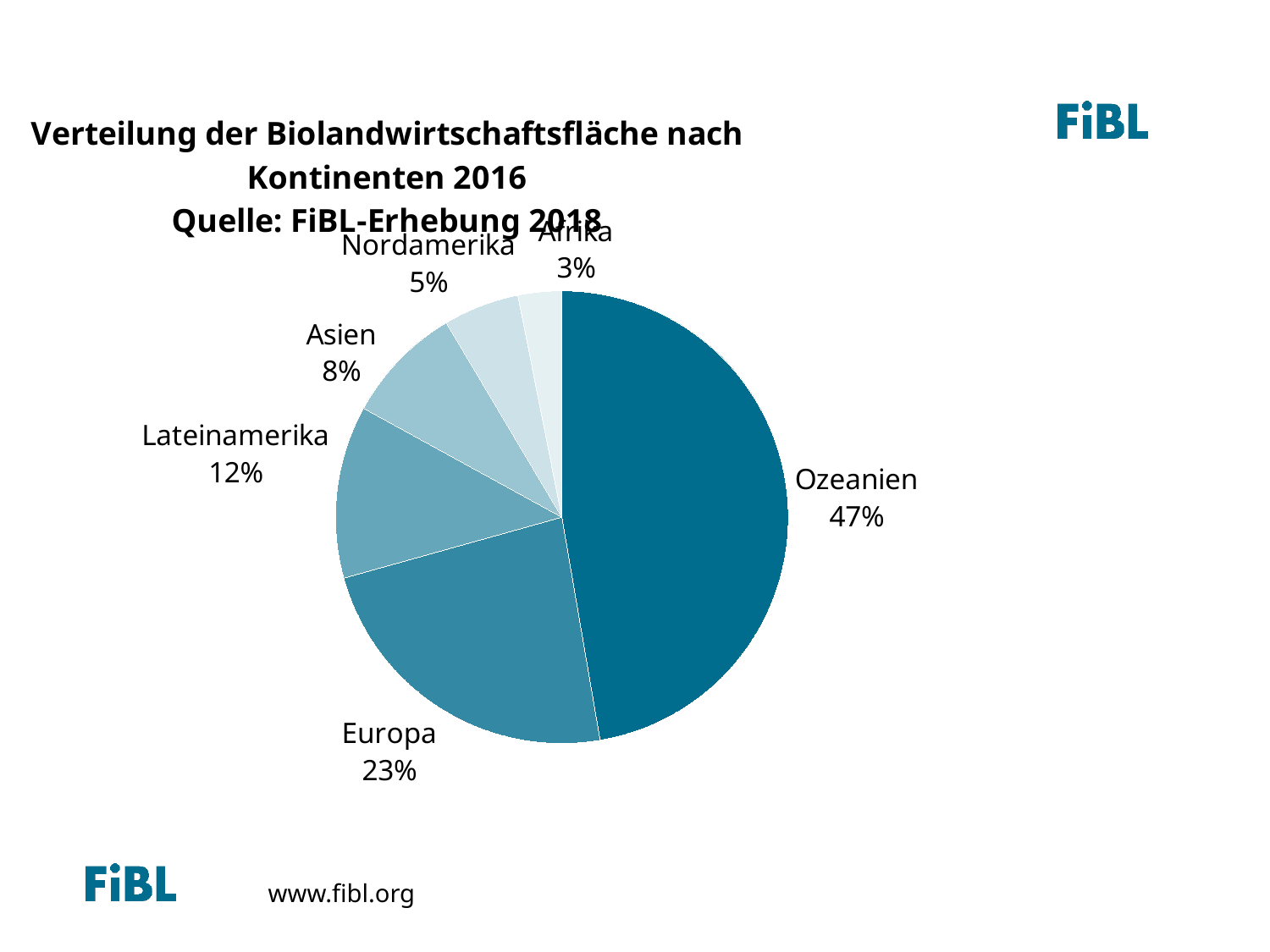
What percentage is shown for Asien? 8% What share of the organic farmland does Ozeanien have? 47% How many slices does the pie chart have? 6 What kind of chart is shown on the slide? pie chart What is the difference in percentage points between Europa and Lateinamerika? 11 percentage points What percentage is shown for Lateinamerika? 12% What percentage is shown for Nordamerika? 5% Which continent has the largest slice of the pie? Ozeanien Which has the larger share, Lateinamerika or Asien? Lateinamerika How many percentage points larger is Ozeanien's share than Europa's? 24 percentage points What percentage is shown for Europa? 23% What year does the chart title say the distribution refers to? 2016